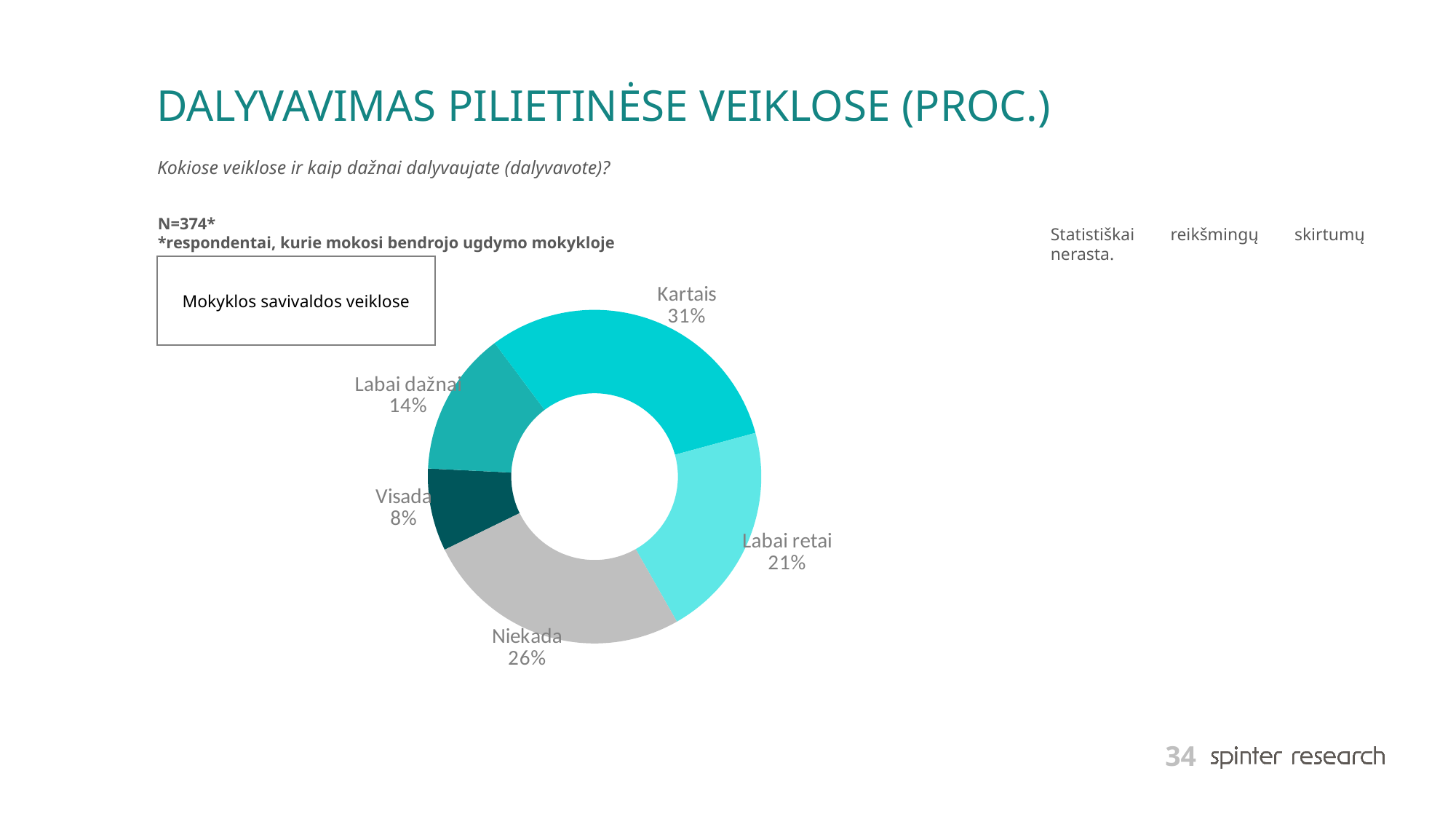
Which category has the smallest share? Visada What is the value for Labai dažnai? 14% What kind of chart is shown on the slide? Doughnut (pie) chart What is the value for Labai retai? 21% How many categories are shown in the chart? 5 What is the value for Visada? 8% What is the difference between the shares for Kartais and Niekada? 5% Which is larger, the share for Labai retai or the share for Labai dažnai? Labai retai Which category has the largest share? Kartais What is the value for Niekada? 26% What activity does the label box next to the chart name? Mokyklos savivaldos veiklose What is the value for Kartais? 31%